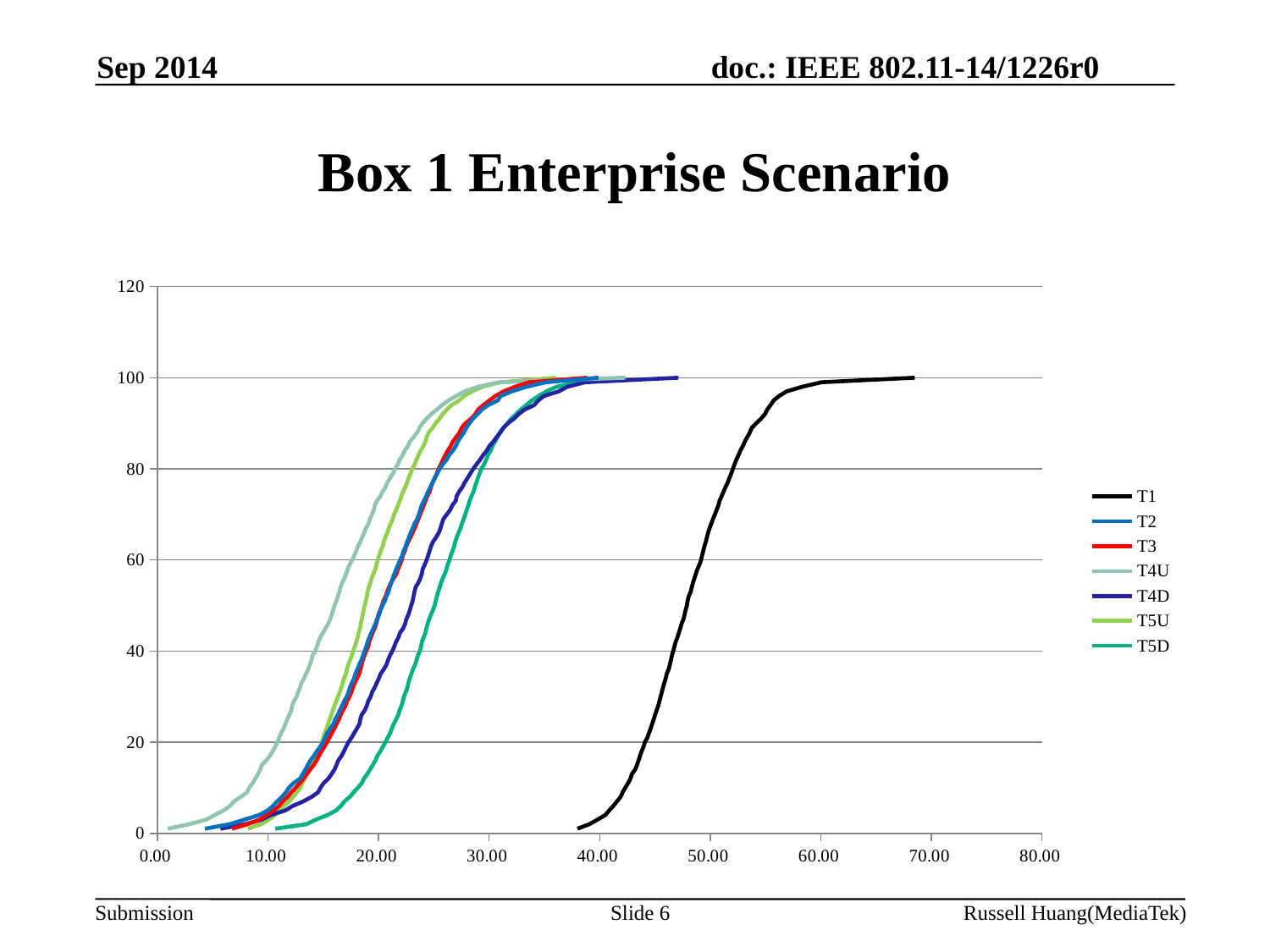
How many series does the legend list? 7 Is the value of the T1 series at x = 40.00 greater or less than 20? less Is the value of the T1 series at x = 60.00 greater or less than 80? greater Do the values of the T1 series rise or fall as x increases? rise What is the title of the chart? Box 1 Enterprise Scenario Which series is drawn in black? T1 Which series lies furthest to the left, reaching 50 at the smallest x value? T4U Is the value of the T5D series at x = 20.00 greater or less than 20? less Which series lies furthest to the right, reaching 100 at the largest x value? T1 What kind of chart is shown on the slide? line chart